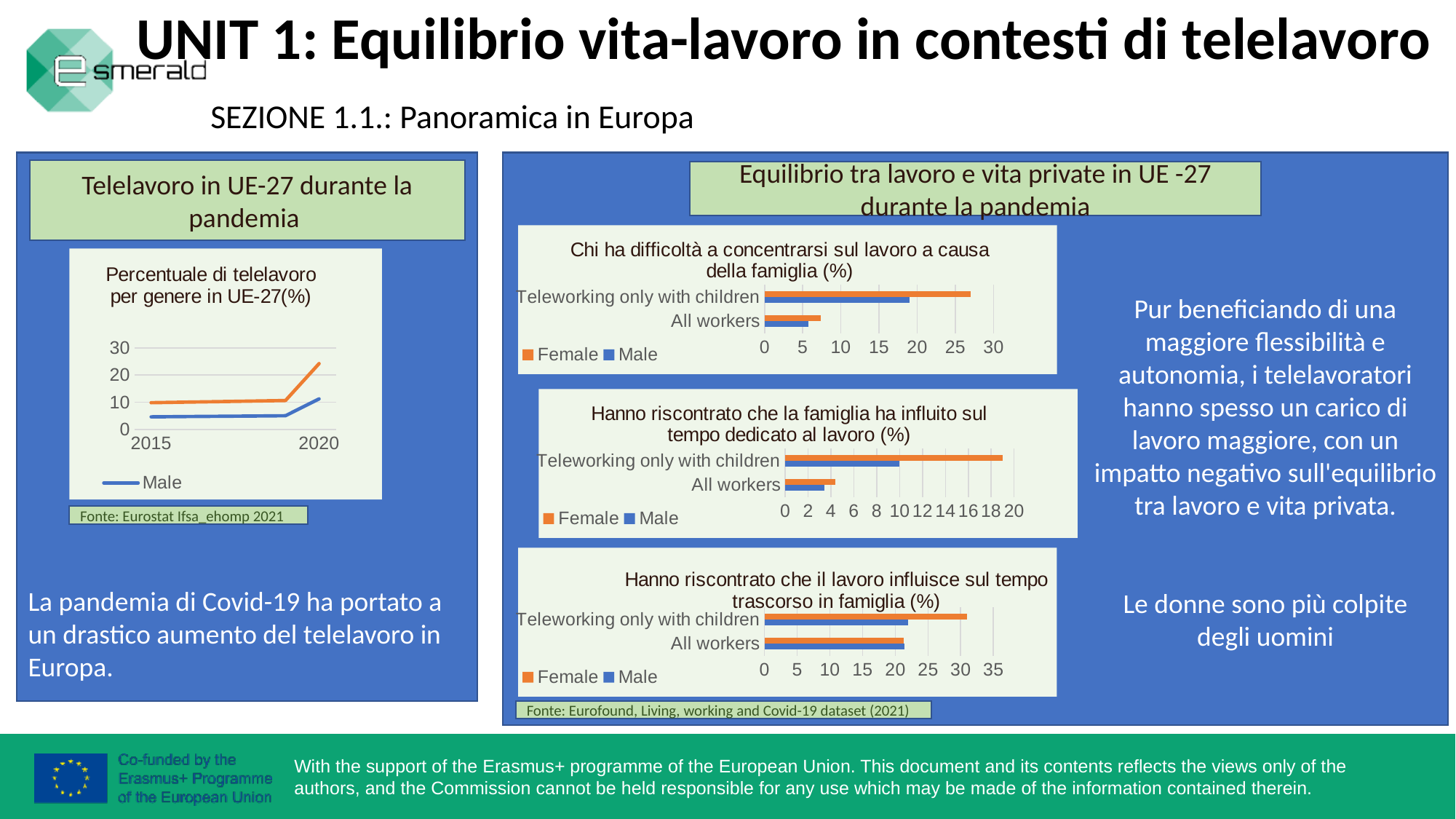
In the chart 'Percentuale di telelavoro per genere in UE-27(%)', does the Male value rise or fall from 2015 to 2020? rise In the chart 'Chi ha difficoltà a concentrarsi sul lavoro a causa della famiglia (%)', is the Female value for 'Teleworking only with children' greater or less than 25? greater In the chart 'Hanno riscontrato che il lavoro influisce sul tempo trascorso in famiglia (%)', which colour represents the Female series? orange What kind of chart is 'Chi ha difficoltà a concentrarsi sul lavoro a causa della famiglia (%)'? bar chart In the chart 'Hanno riscontrato che la famiglia ha influito sul tempo dedicato al lavoro (%)', is the Female value for 'Teleworking only with children' greater or less than 16? greater How many categories are shown in the chart 'Chi ha difficoltà a concentrarsi sul lavoro a causa della famiglia (%)'? 2 How many series does the legend of the chart 'Chi ha difficoltà a concentrarsi sul lavoro a causa della famiglia (%)' list? 2 In the chart 'Percentuale di telelavoro per genere in UE-27(%)', is the Male value in 2020 greater or less than 20? less What kind of chart is 'Percentuale di telelavoro per genere in UE-27(%)'? line chart In the chart 'Chi ha difficoltà a concentrarsi sul lavoro a causa della famiglia (%)', which category has the highest Female value? Teleworking only with children In the chart 'Chi ha difficoltà a concentrarsi sul lavoro a causa della famiglia (%)', which is larger for 'Teleworking only with children', Female or Male? Female